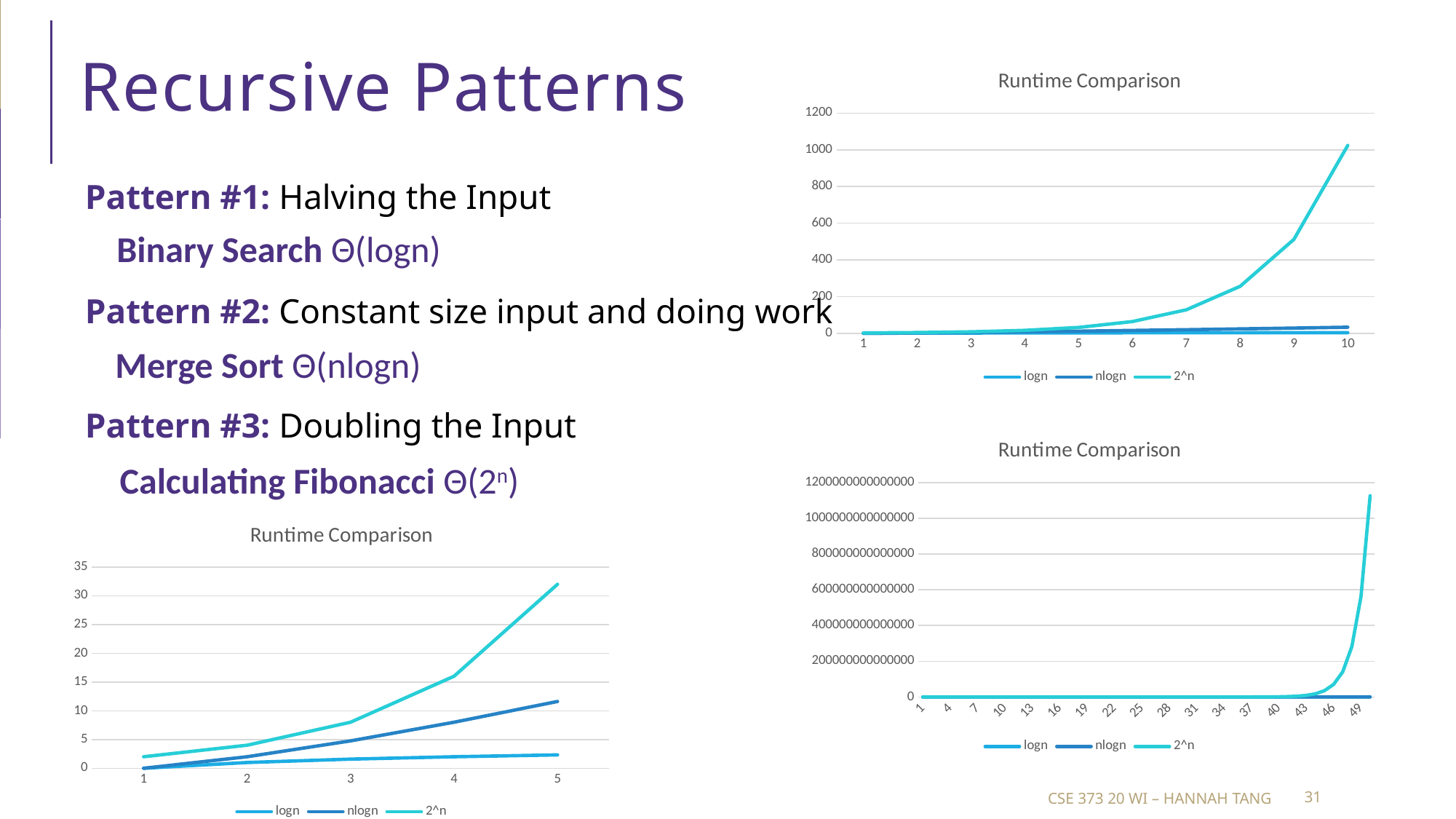
In the top-right Runtime Comparison chart, is the value of 2^n at x = 8 greater or less than 200? greater How many series does the legend of the top-right Runtime Comparison chart list? 3 How many x-axis points does the top-right Runtime Comparison chart show? 10 In the bottom-right Runtime Comparison chart, does the 2^n series rise or fall as x increases? rise In the bottom-left Runtime Comparison chart, is the value of nlogn at x = 5 greater or less than 10? greater What is the title of the bottom-right chart? Runtime Comparison In the bottom-left Runtime Comparison chart, which series has the lowest value at x = 5? logn In the bottom-left Runtime Comparison chart, is the value of 2^n at x = 5 greater or less than 30? greater In the bottom-left Runtime Comparison chart, which series has the highest value at x = 5? 2^n What kind of chart is the bottom-left Runtime Comparison chart? line chart